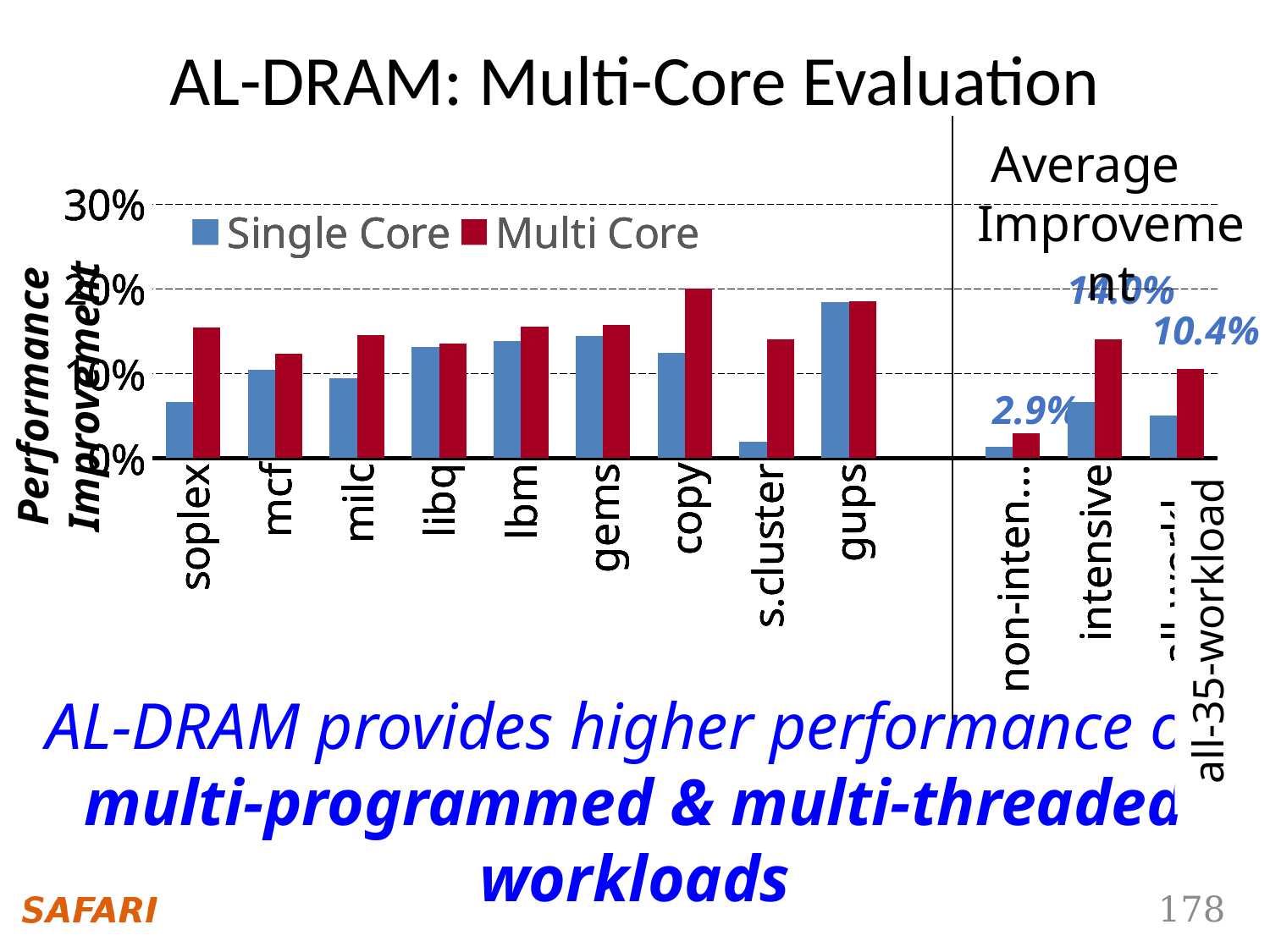
What are the two series named in the chart legend? Single Core and Multi Core Which colour represents the Multi Core series in the chart? red What average improvement value is labelled above the all-35-workload bars? 10.4% Which benchmark has the highest Single Core bar? gups Is the Multi Core value for gups greater or less than 10%? greater How many series does the chart legend list? 2 What kind of chart is shown on the slide? bar chart Among the nine individual benchmarks, which has the lowest Single Core bar? s.cluster For soplex, which is larger: the Single Core or the Multi Core value? Multi Core Which benchmark has the highest Multi Core bar? copy Is the Single Core value for s.cluster greater or less than 10%? less How many benchmark categories are plotted to the left of the vertical divider line (before the average group)? 9